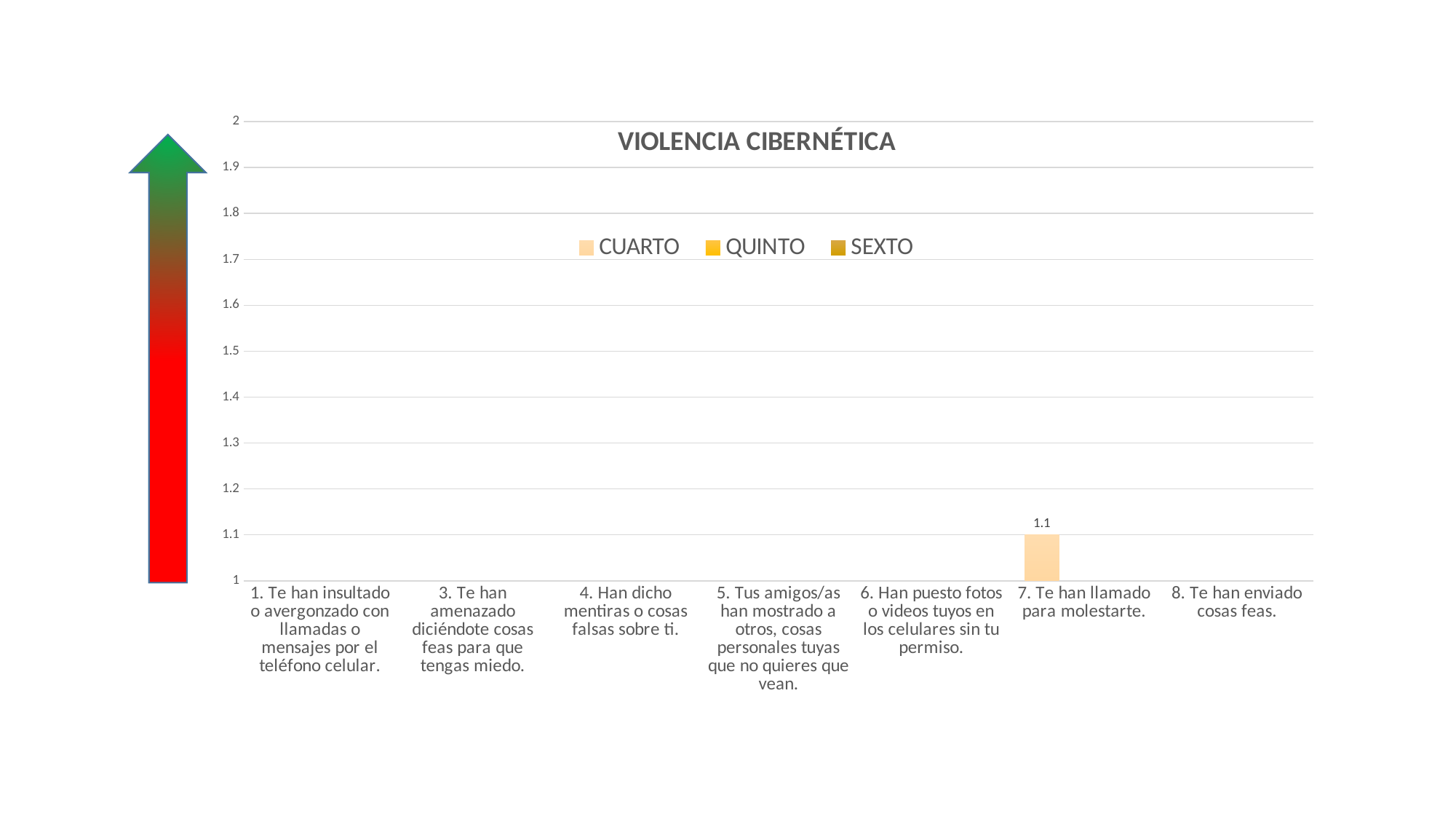
Which series does the legend list first? CUARTO What kind of chart is shown on the slide? bar chart Is the CUARTO value for "7. Te han llamado para molestarte." greater or less than 1.5? less What is the highest value shown on the y axis? 2 Which series does the only visible bar belong to? CUARTO What is the title of the chart? VIOLENCIA CIBERNÉTICA What is the CUARTO value for "7. Te han llamado para molestarte."? 1.1 How many series does the legend list? 3 Is the CUARTO value for "7. Te han llamado para molestarte." greater or less than 1? greater Which category has the tallest bar on the chart? 7. Te han llamado para molestarte. How many categories are shown on the x axis? 7 What is the lowest value shown on the y axis? 1